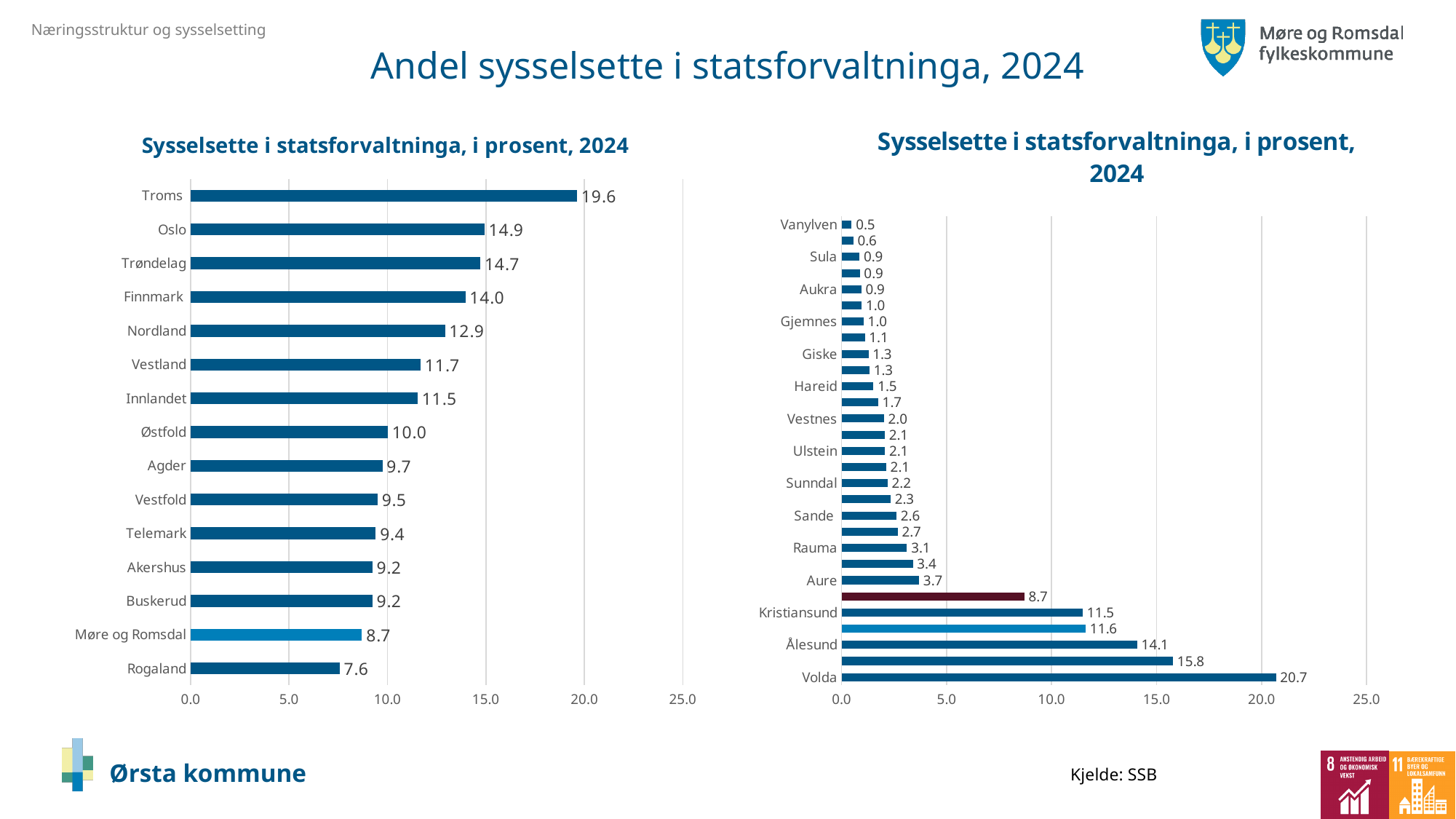
On the left chart, what is the value for Troms? 19.6 On the right chart, what is the difference between the values for Volda and Ålesund? 6.6 On the left chart, what is the difference between the values for Oslo and Trøndelag? 0.2 On the right chart, what is the value for Aure? 3.7 On the right chart, what is the value for Volda? 20.7 On the right chart, which category has the lowest value? Vanylven On the left chart, which category has the lowest value? Rogaland On the left chart, which category has the highest value? Troms On the left chart, how many categories are plotted? 15 On the left chart, what is the value for Møre og Romsdal? 8.7 What kind of chart is the left chart? Bar chart On the left chart, which is larger, the value for Nordland or the value for Vestland? Nordland